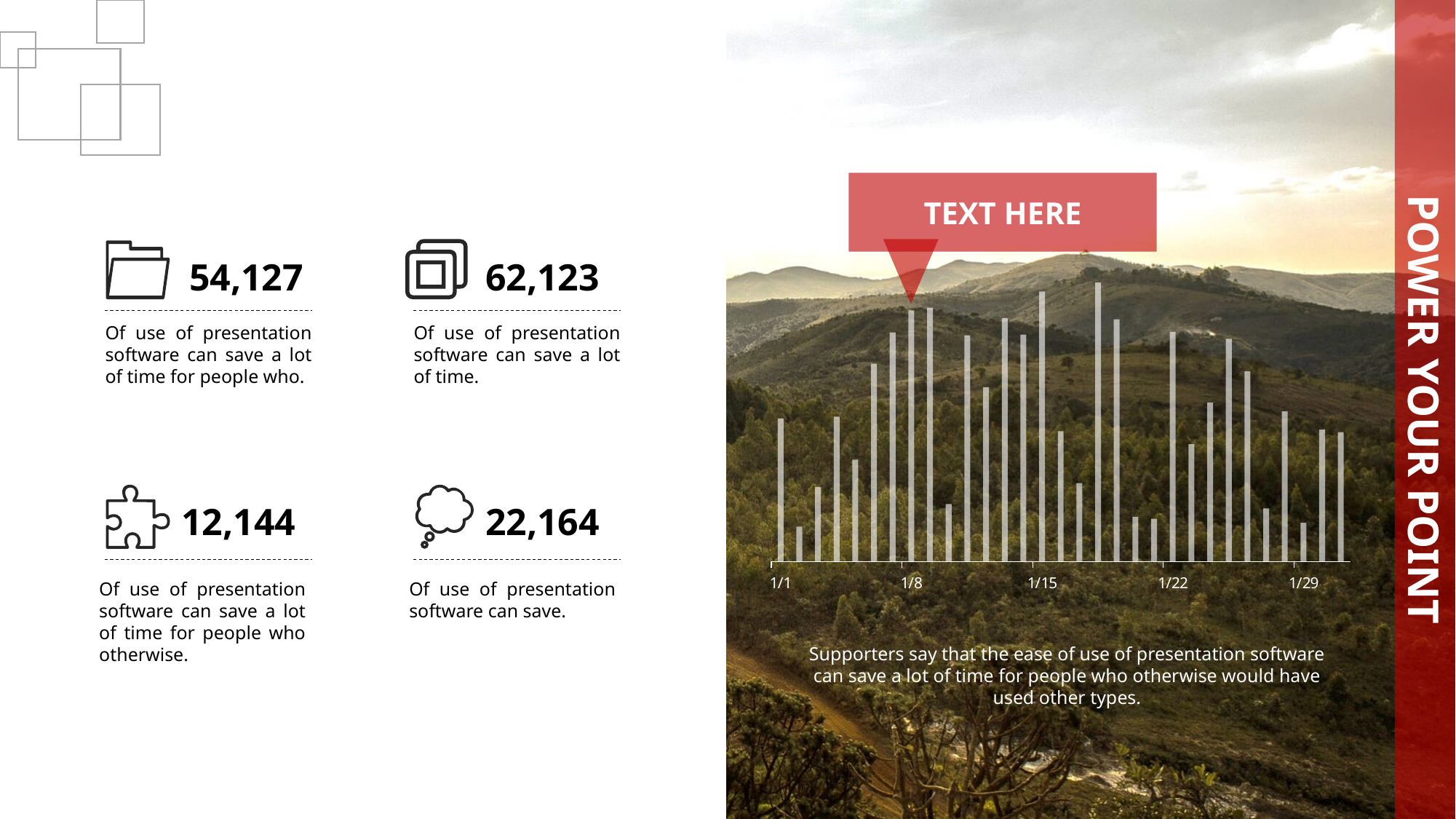
Do the bars generally rise or fall from 1/1 to 1/8? rise Which labeled date has the taller bar, 1/8 or 1/29? 1/8 Do the bars generally rise or fall from 1/22 to 1/29? fall Of the five labeled dates on the x axis, which one has the shortest bar? 1/29 Which labeled date has the taller bar, 1/22 or 1/29? 1/22 What is the last date label on the x axis of the chart? 1/29 Which labeled date has the taller bar, 1/1 or 1/15? 1/15 How many date labels are shown along the x axis of the chart? 5 What is the first date label on the x axis of the chart? 1/1 What kind of chart is shown on the right side of the slide? bar chart